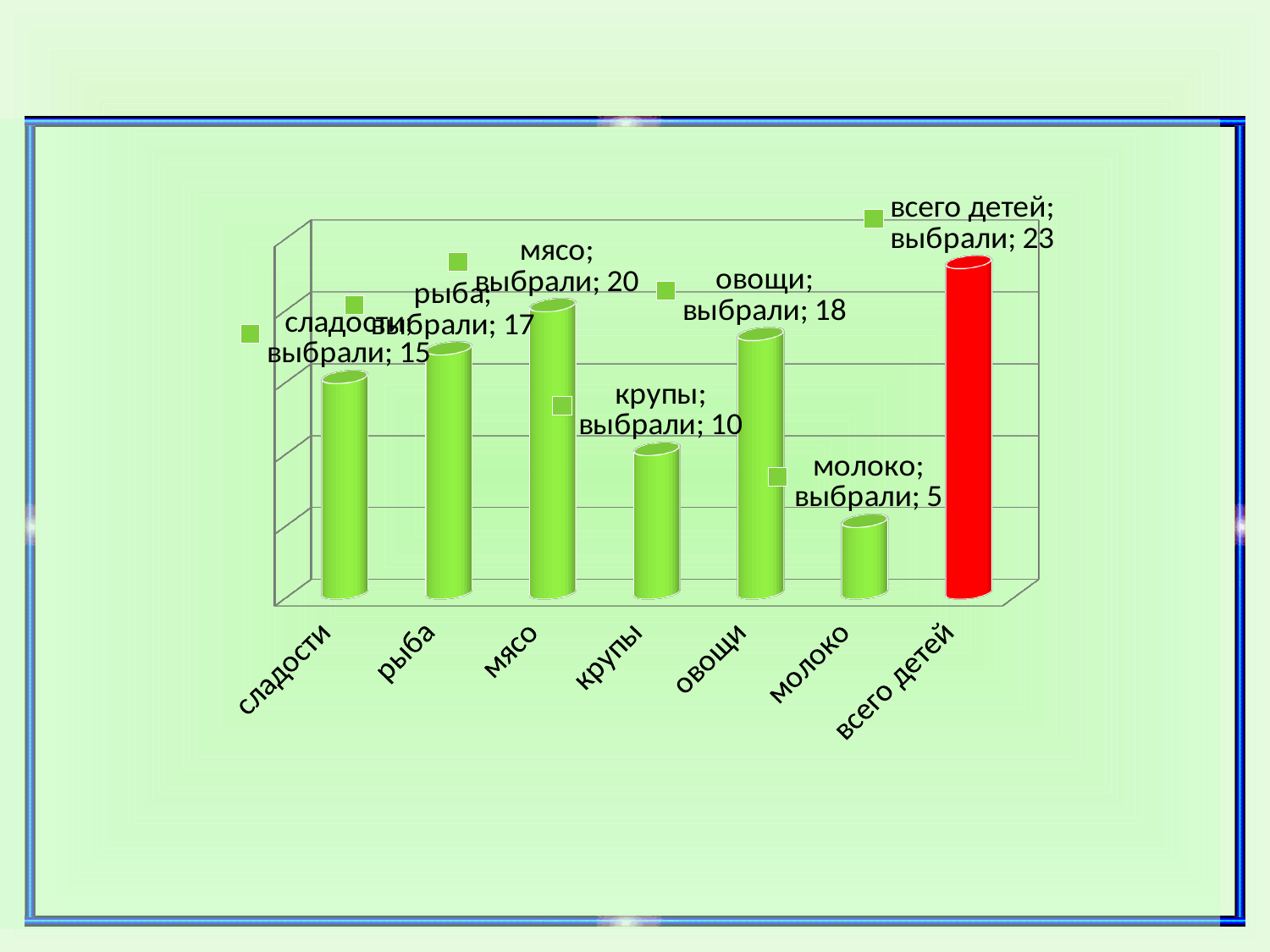
What is the difference between the values for рыба and крупы? 7 Which category has the highest value? всего детей What is the value for овощи? 18 How many categories are shown on the x axis? 7 Which is larger, the value for овощи or the value for рыба? овощи What is the difference between the values for всего детей and мясо? 3 What is the value for мясо? 20 Which category has the lowest value? молоко What is the value for молоко? 5 Which bar is coloured red rather than green? всего детей What is the value for сладости? 15 What kind of chart is this? bar chart